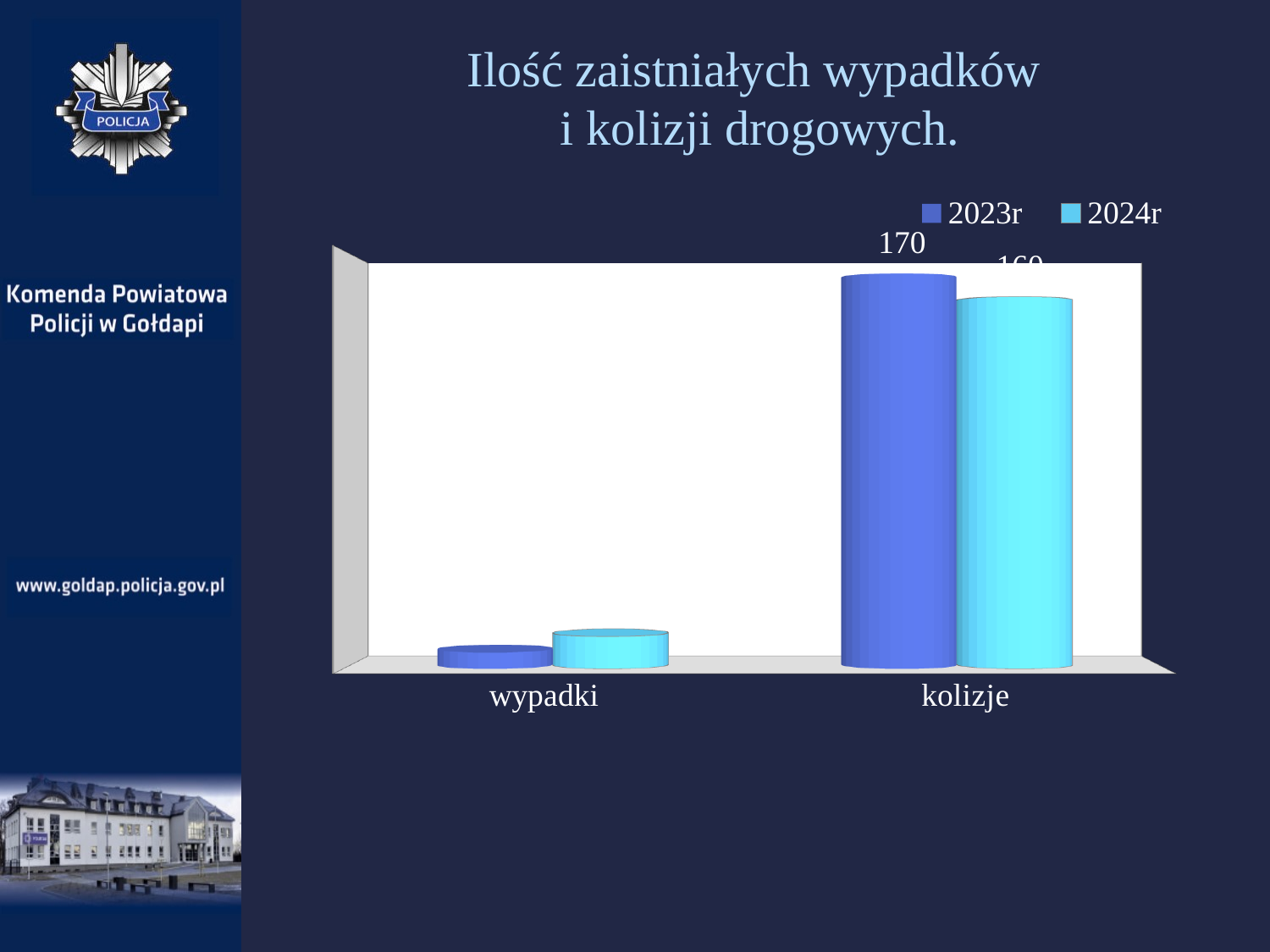
For kolizje, which series has the larger value, 2023r or 2024r? 2023r Do the values rise or fall going from wypadki to kolizje? rise How many categories are shown on the x axis? 2 What is the title of the chart? Ilość zaistniałych wypadków i kolizji drogowych. What kind of chart is shown on the slide? bar chart Which category has the lowest values on the chart? wypadki What is the value for kolizje in the 2023r series? 170 Which category has the highest values on the chart? kolizje Which series is shown in the lighter cyan colour? 2024r For wypadki, which series has the larger value, 2023r or 2024r? 2024r How many series does the legend list? 2